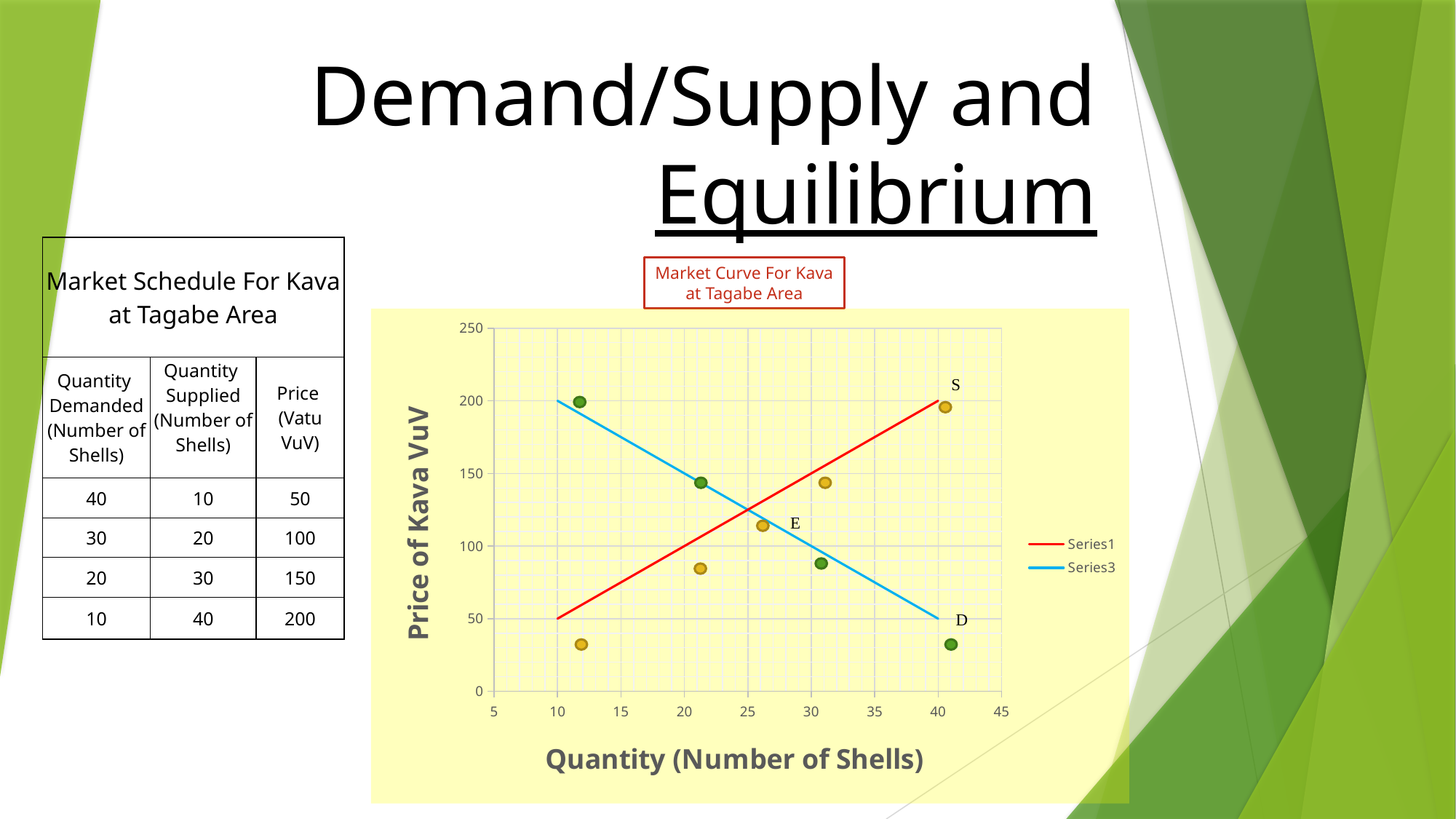
What is the price for Series3 at a quantity of 10? 200 What are the two entries in the chart legend? Series1 and Series3 At a quantity of 10, which series has the higher price, Series1 or Series3? Series3 By how much does the Series1 price at a quantity of 40 exceed its price at a quantity of 10? 150 Is the price for Series3 at a quantity of 40 greater or less than 100? less What is the price for Series1 at a quantity of 40? 200 What kind of chart is shown on the slide? line chart Does Series1 (the red line) rise or fall as quantity increases along the x axis? rise What is the price for Series1 at a quantity of 10? 50 Does Series3 (the blue line) rise or fall as quantity increases along the x axis? fall What is the title of the chart? Market Curve For Kava at Tagabe Area How many series does the chart legend list? 2